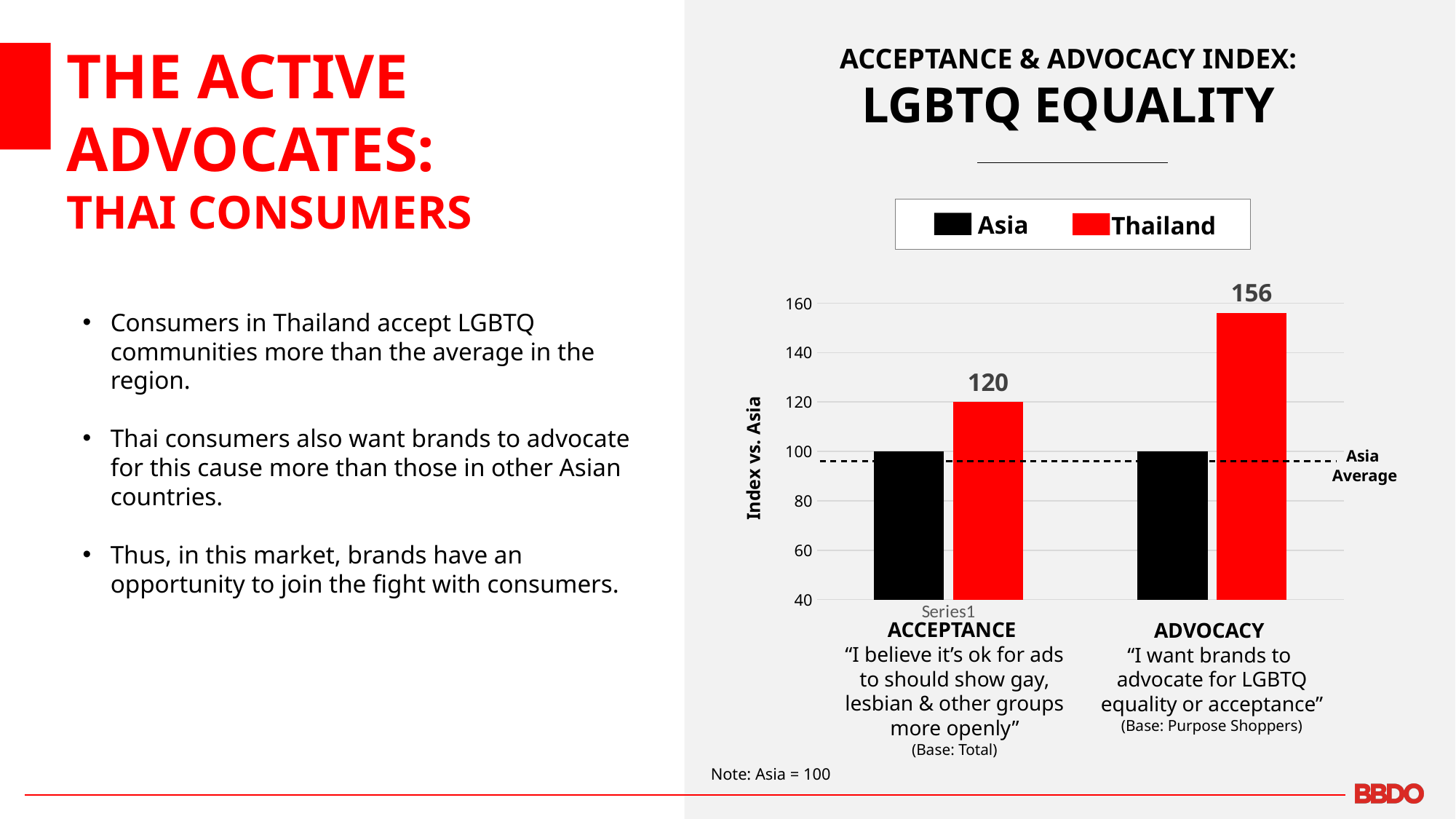
What is the Asia index value for Acceptance? 100 What is the label of the vertical axis of the chart? Index vs. Asia Is the Thailand value for Advocacy greater or less than 140? greater What kind of chart is shown on the slide? Bar chart Which colour represents Thailand in the chart? Red How many series does the chart legend list? 2 How many categories are shown on the x axis of the chart? 2 Which category has the higher Thailand index value, Acceptance or Advocacy? Advocacy What is the difference between the Thailand index values for Advocacy and Acceptance? 36 What is the Thailand index value for Acceptance? 120 For Advocacy, which is larger, the Asia value or the Thailand value? Thailand What is the Thailand index value for Advocacy? 156